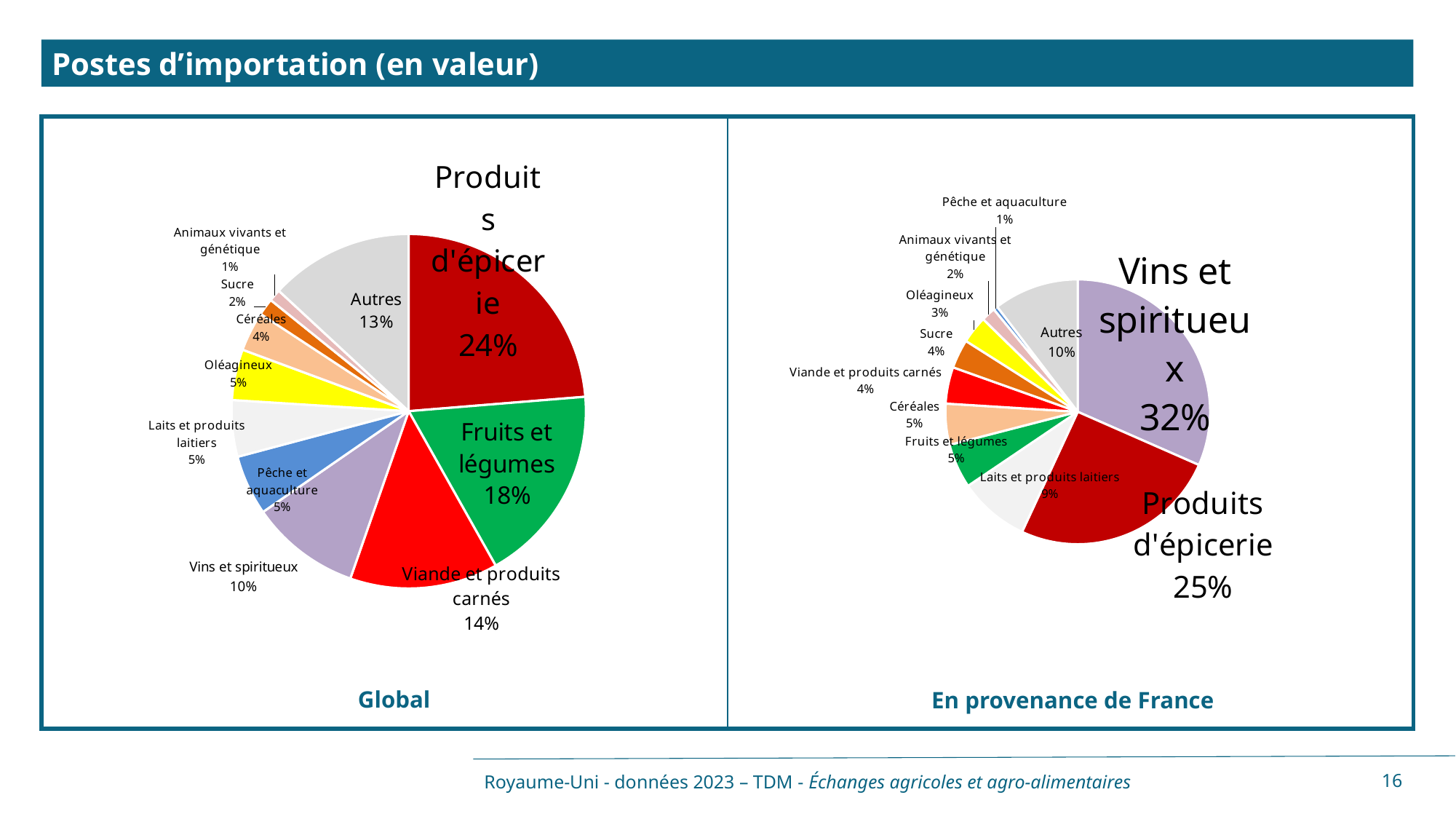
What type of chart is used on this slide? Pie chart In the 'Global' pie chart, which category has the largest share? Produits d'épicerie In the 'Global' pie chart, which category has the smallest share? Animaux vivants et génétique In the 'En provenance de France' pie chart, which is larger: Produits d'épicerie or Autres? Produits d'épicerie In the 'En provenance de France' pie chart, what share do Vins et spiritueux represent? 32% In the 'Global' pie chart, how many categories are shown? 11 In the 'Global' pie chart, what share do Produits d'épicerie represent? 24% In the 'Global' pie chart, what share do Fruits et légumes represent? 18% In the 'En provenance de France' pie chart, which category has the largest share? Vins et spiritueux In the 'En provenance de France' pie chart, what share do Laits et produits laitiers represent? 9% In the 'En provenance de France' pie chart, what is the difference between the shares of Vins et spiritueux and Produits d'épicerie? 7 percentage points In the 'Global' pie chart, what is the difference between the shares of Produits d'épicerie and Viande et produits carnés? 10 percentage points